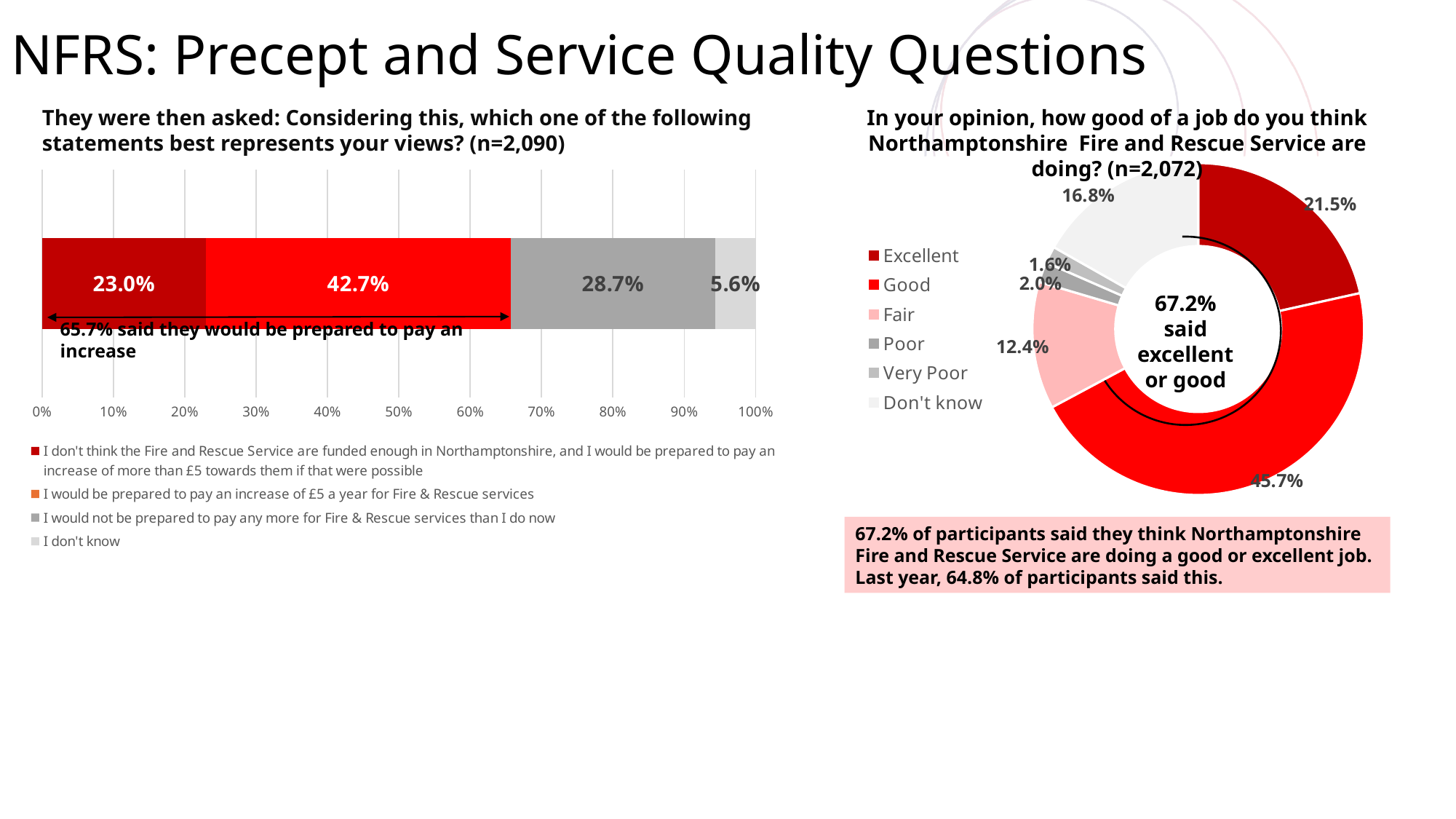
What kind of chart is the left chart? Stacked bar chart On the right chart, which is larger: the share for 'Fair' or the share for 'Don't know'? Don't know On the left chart, what percentage of respondents said they would be prepared to pay an increase of £5 a year for Fire & Rescue services? 42.7% How many categories does the right chart's legend list? 6 On the right chart, what percentage rated the service as 'Very Poor'? 1.6% How many entries does the legend of the left chart list? 4 On the left chart, what is the difference between the share prepared to pay £5 a year and the share prepared to pay more than £5? 19.7% On the right chart, what percentage rated Northamptonshire Fire and Rescue Service as 'Good'? 45.7% On the left chart, what percentage said they would not be prepared to pay any more for Fire & Rescue services than they do now? 28.7% On the left chart, what percentage answered 'I don't know'? 5.6% On the left chart, which response has the largest share? I would be prepared to pay an increase of £5 a year for Fire & Rescue services On the right chart, which rating has the smallest share? Very Poor